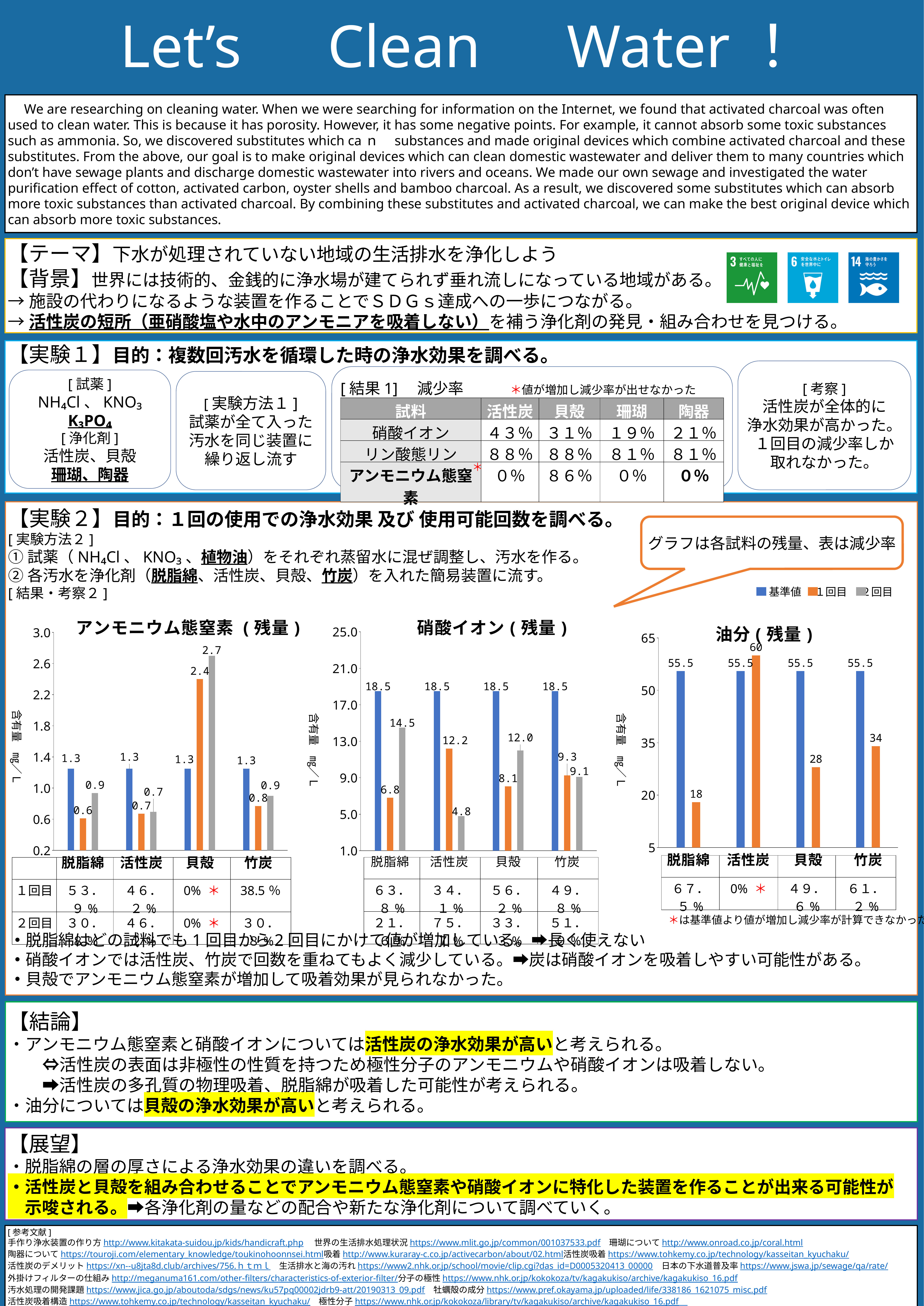
In the アンモニウム態窒素（残量） chart, which category has the highest 2回目 value? 貝殻 In the 硝酸イオン（残量） chart, what is the 1回目 value for 脱脂綿? 6.8 In the 油分（残量） chart, what is the difference between the 基準値 and the 1回目 value for 貝殻? 27.5 In the 油分（残量） chart, what is the 1回目 value for 活性炭? 60 In the 硝酸イオン（残量） chart, is the 1回目 value for 活性炭 larger or the 2回目 value for 活性炭? 1回目 In the 油分（残量） chart, which category has the lowest 1回目 value? 脱脂綿 How many series does the shared legend for the three charts list? 3 In the 硝酸イオン（残量） chart, which category has the lowest 2回目 value? 活性炭 In the アンモニウム態窒素（残量） chart, what is the 2回目 value for 脱脂綿? 0.9 In the アンモニウム態窒素（残量） chart, what is the difference between the 2回目 and 1回目 values for 貝殻? 0.3 In the アンモニウム態窒素（残量） chart, what is the 1回目 value for 貝殻? 2.4 In the 硝酸イオン（残量） chart, what is the 基準値 value for 竹炭? 18.5